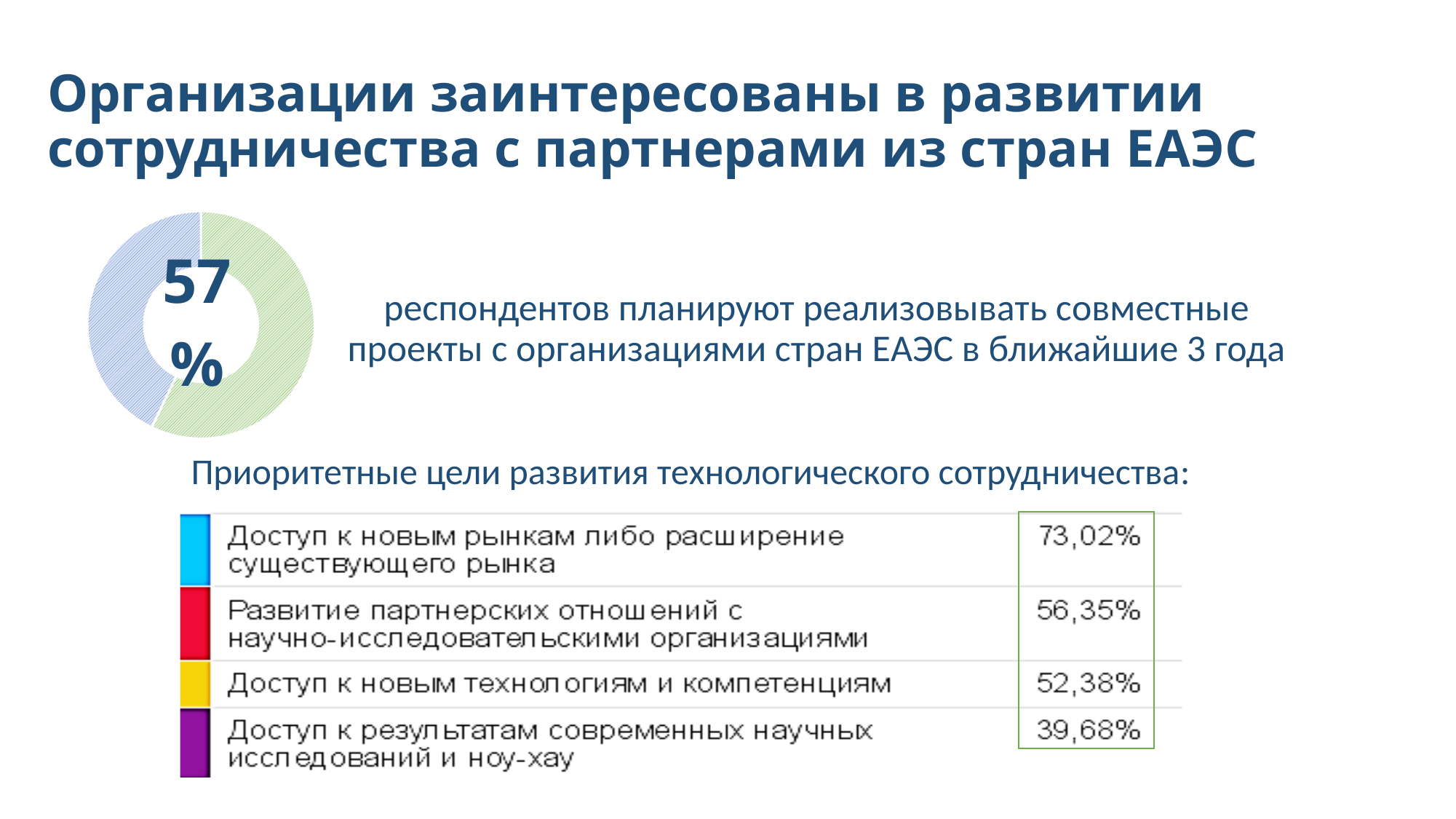
In the list of priority goals of technological cooperation, which is larger: the value for 'Развитие партнерских отношений с научно-исследовательскими организациями' or for 'Доступ к новым технологиям и компетенциям'? Развитие партнерских отношений с научно-исследовательскими организациями In the list of priority goals of technological cooperation, which goal has the lowest value? Доступ к результатам современных научных исследований и ноу-хау In the list of priority goals of technological cooperation, which goal has the highest value? Доступ к новым рынкам либо расширение существующего рынка How many segments does the doughnut chart have? 2 In the doughnut chart, what share of respondents plan to implement joint projects with organisations from EAEU countries in the next 3 years? 57% In the list of priority goals of technological cooperation, what is the value for 'Доступ к новым рынкам либо расширение существующего рынка'? 73,02% What kind of chart is shown on the left of the slide next to the text about respondents? doughnut chart In the list of priority goals of technological cooperation, what is the value for 'Доступ к результатам современных научных исследований и ноу-хау'? 39,68% In the list of priority goals of technological cooperation, what is the value for 'Развитие партнерских отношений с научно-исследовательскими организациями'? 56,35% How many priority goals of technological cooperation are listed on the slide? 4 In the list of priority goals of technological cooperation, what is the value for 'Доступ к новым технологиям и компетенциям'? 52,38% In the list of priority goals of technological cooperation, what is the difference between the values for 'Доступ к новым рынкам либо расширение существующего рынка' and 'Доступ к результатам современных научных исследований и ноу-хау'? 33,34%